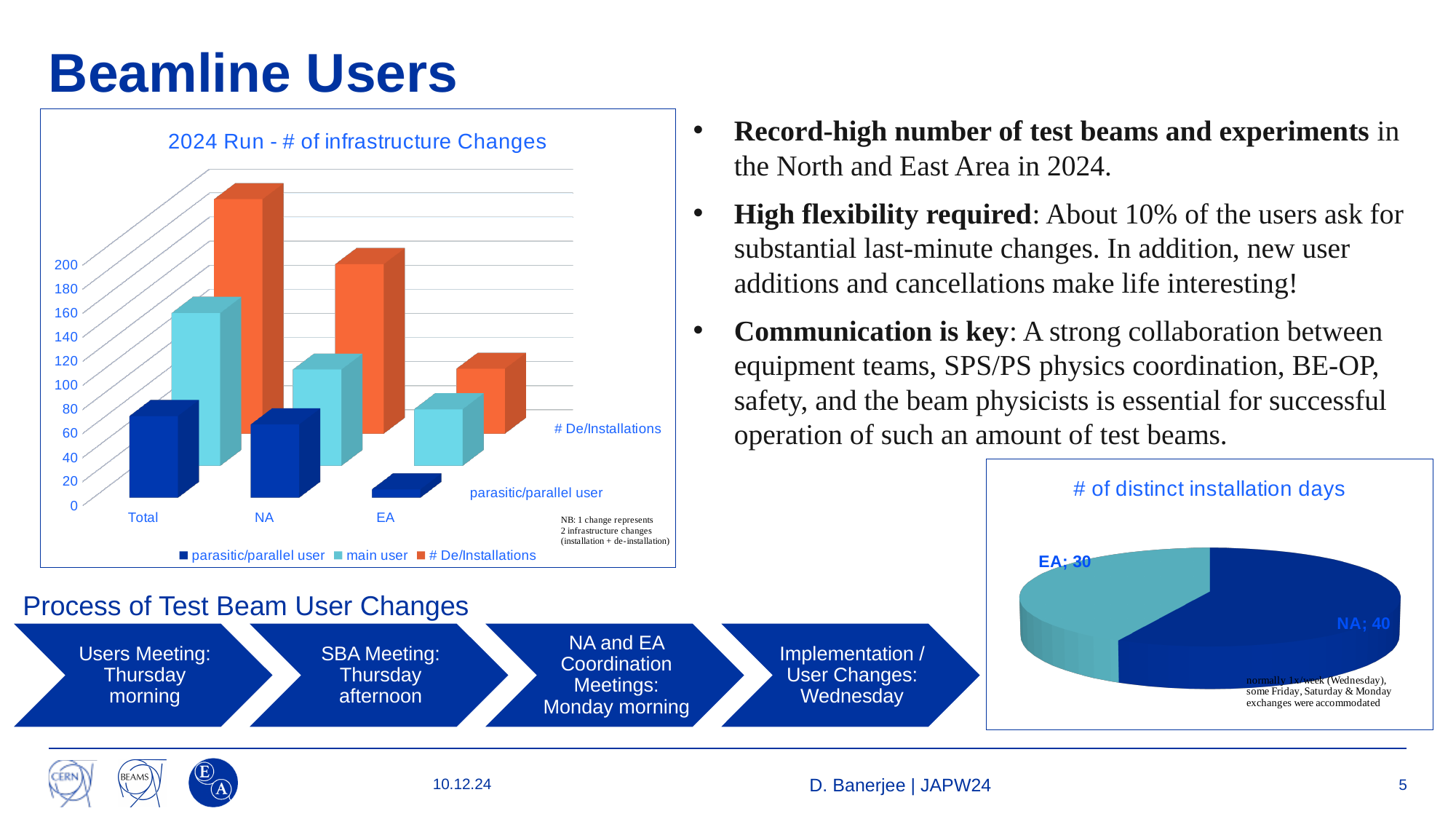
In the '2024 Run - # of infrastructure Changes' chart, is the parasitic/parallel user value for EA greater or less than 20? less In the '# of distinct installation days' pie chart, how many installation days are shown for NA? 40 What kind of chart is '2024 Run - # of infrastructure Changes'? Bar chart In the '# of distinct installation days' pie chart, which area has the larger number of installation days? NA How many series does the legend of the '2024 Run - # of infrastructure Changes' chart list? 3 In the '# of distinct installation days' pie chart, how many installation days are shown for EA? 30 In the '# of distinct installation days' pie chart, what is the difference between the NA and EA values? 10 In the '2024 Run - # of infrastructure Changes' chart, which series has the tallest bar for the Total category? # De/Installations In the '2024 Run - # of infrastructure Changes' chart, which series has the smallest bar for the EA category? parasitic/parallel user In the '2024 Run - # of infrastructure Changes' chart, is the # De/Installations bar larger for NA or for EA? NA How many categories are shown on the x axis of the '2024 Run - # of infrastructure Changes' chart? 3 How many slices does the '# of distinct installation days' pie chart have? 2